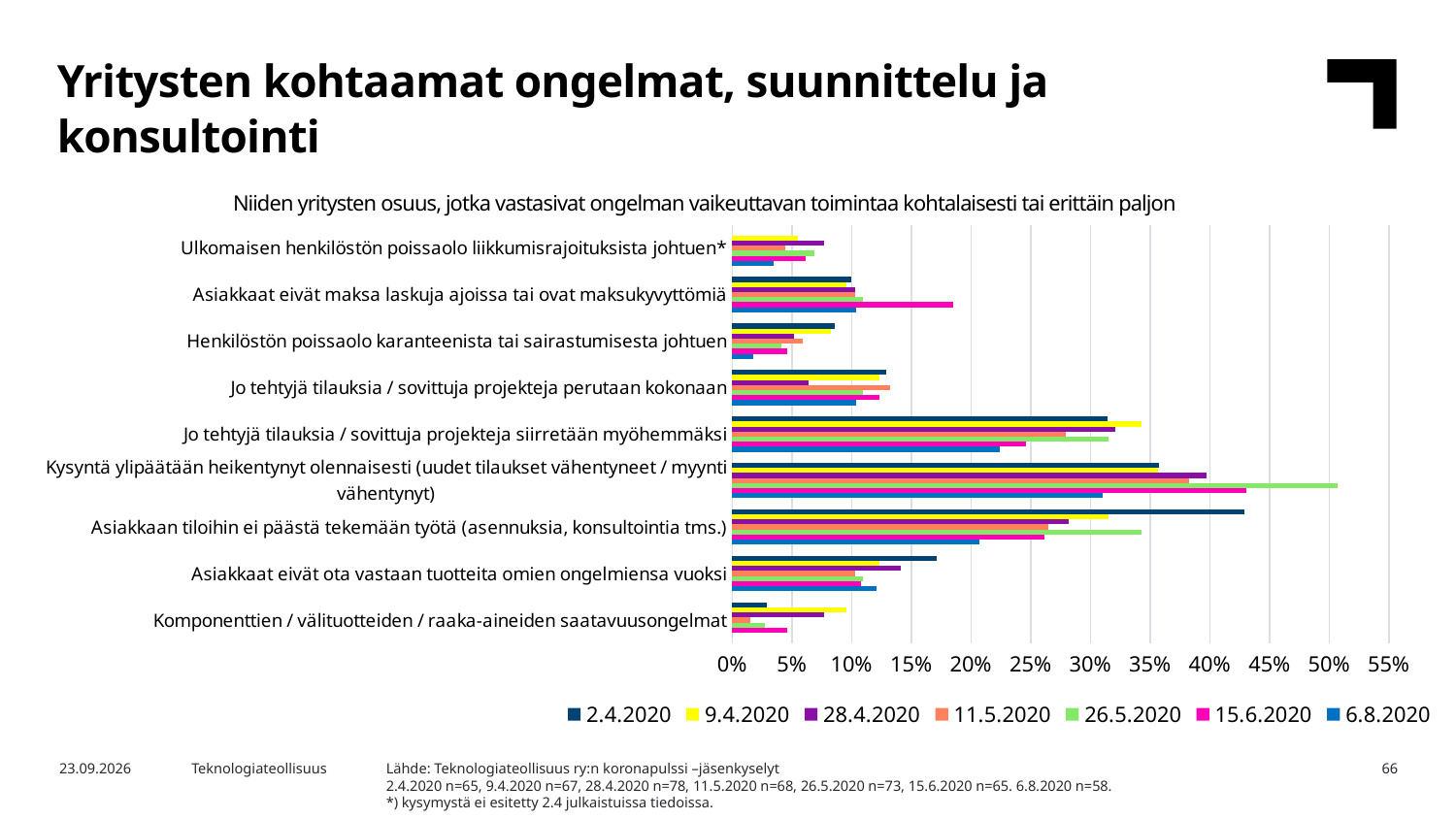
For the category 'Kysyntä ylipäätään heikentynyt olennaisesti', which survey date has the highest value? 26.5.2020 What kind of chart is shown on the slide? Bar chart Which category has the longest bar on the chart overall? Kysyntä ylipäätään heikentynyt olennaisesti (uudet tilaukset vähentyneet / myynti vähentynyt) Is the 26.5.2020 value for 'Kysyntä ylipäätään heikentynyt olennaisesti' greater or less than 45%? greater Is the 2.4.2020 value for 'Asiakkaan tiloihin ei päästä tekemään työtä' greater or less than 40%? greater How many series does the chart legend list? 7 Which colour represents the 26.5.2020 series in the legend? Light green For 'Asiakkaat eivät maksa laskuja ajoissa tai ovat maksukyvyttömiä', which is larger: the 15.6.2020 value or the 2.4.2020 value? 15.6.2020 Is the 2.4.2020 value for 'Komponenttien / välituotteiden / raaka-aineiden saatavuusongelmat' greater or less than 5%? less How many categories (problem types) are listed on the chart's vertical axis? 9 For the category 'Asiakkaan tiloihin ei päästä tekemään työtä', which survey date has the highest value? 2.4.2020